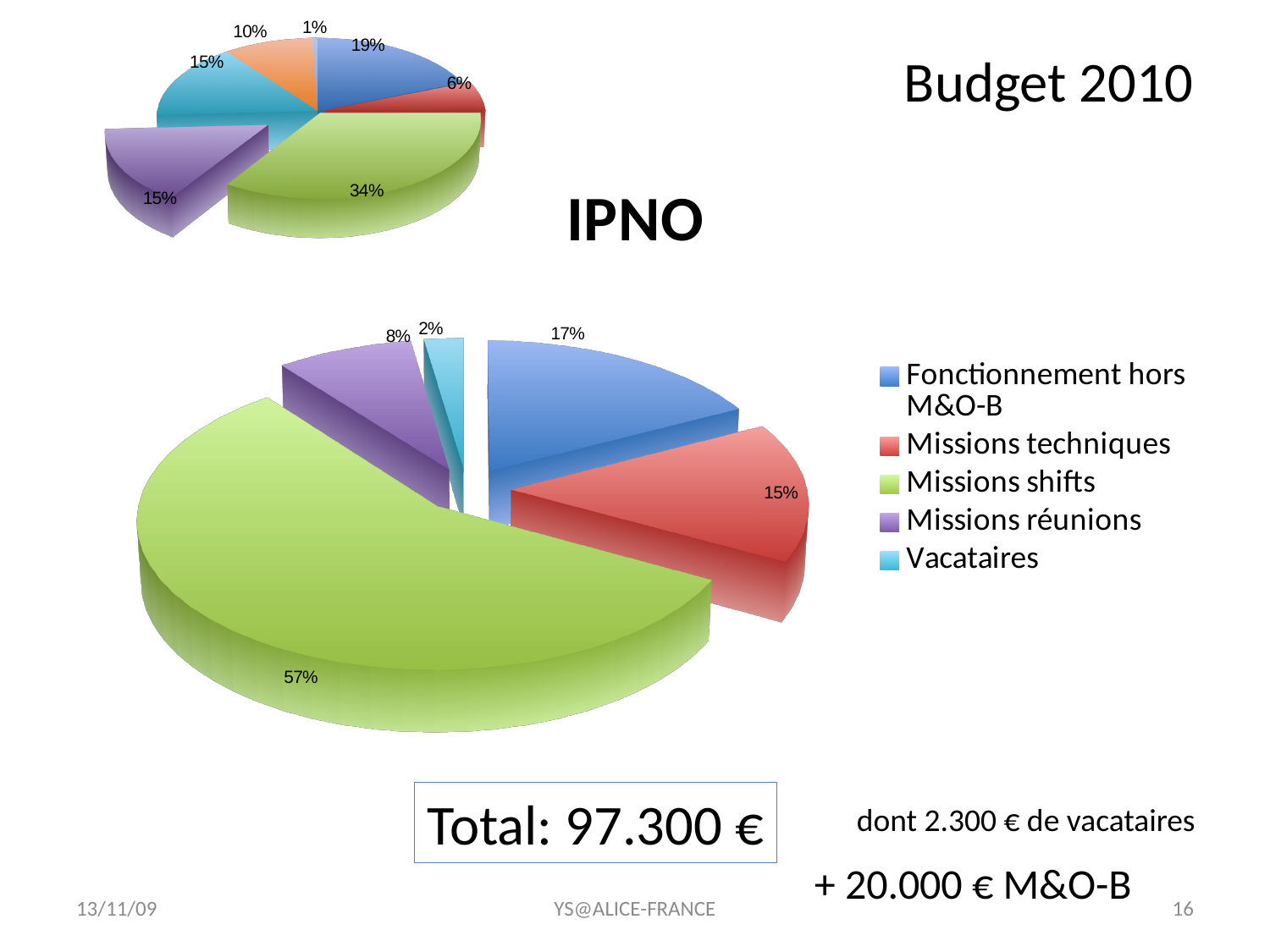
In the small pie chart at the top left of the slide, what is the largest labelled share? 34% In the large IPNO pie chart, what share is labelled for Missions techniques? 15% In the large IPNO pie chart, what share is labelled for Vacataires? 2% In the large IPNO pie chart, what share is labelled for Missions shifts? 57% How many categories does the legend of the large IPNO pie chart list? 5 In the large IPNO pie chart, which is larger: Missions réunions or Missions techniques? Missions techniques What kind of chart is the large IPNO chart? pie chart In the large IPNO pie chart, which category has the smallest slice? Vacataires In the large IPNO pie chart, which category has the largest slice? Missions shifts How many slices does the small pie chart at the top left of the slide have? 7 In the large IPNO pie chart, what is the difference in percentage points between Missions shifts and Fonctionnement hors M&O-B? 40 In the large IPNO pie chart, what share is labelled for Fonctionnement hors M&O-B? 17%